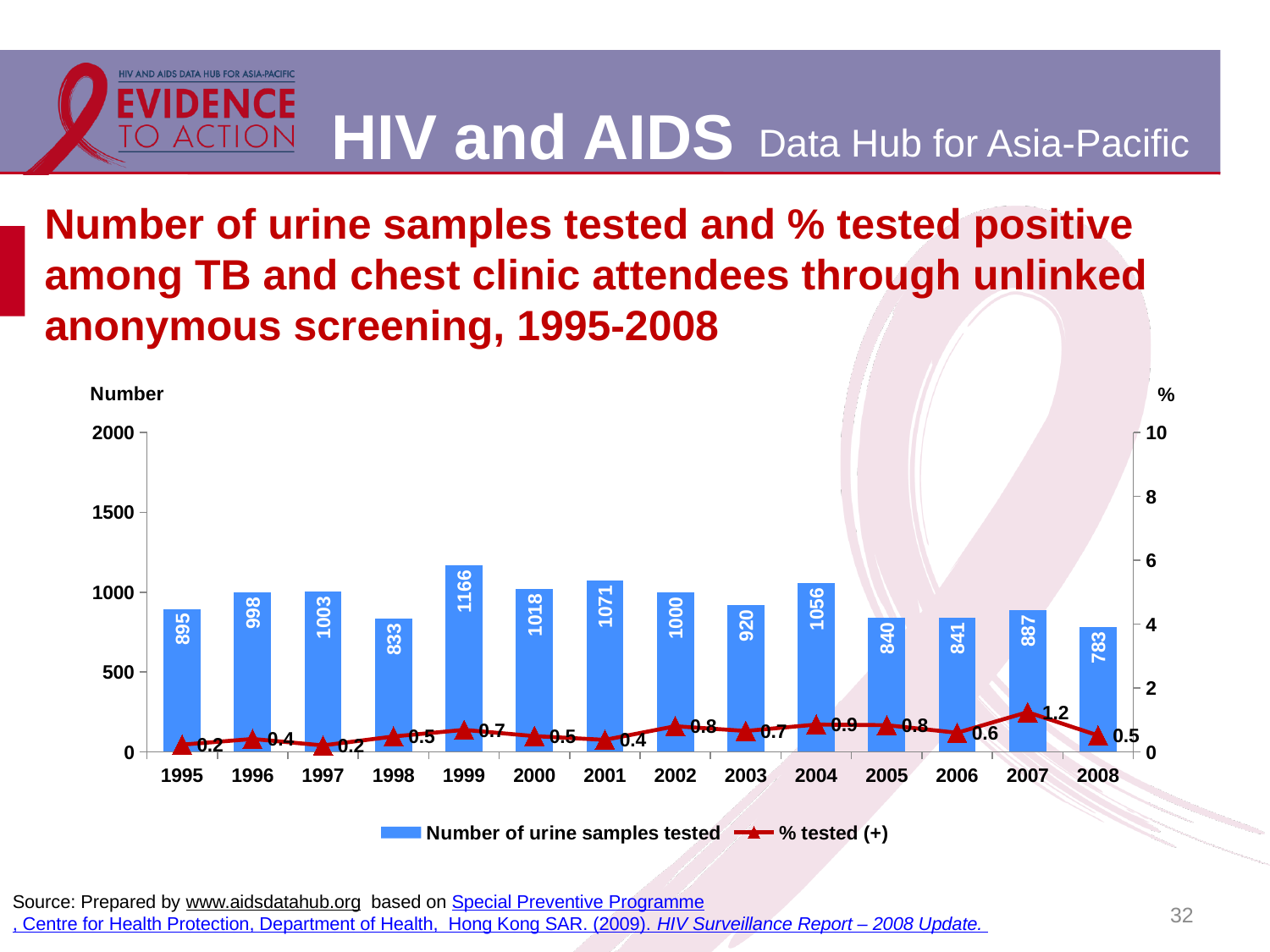
Which year had the highest number of urine samples tested? 1999 How many series does the chart legend list? 2 What colour are the bars showing the number of urine samples tested? Blue What was the % tested positive in 2007? 1.2 How many years are shown on the x axis of the chart? 14 Which year had more urine samples tested, 2001 or 2004? 2001 Which year had the lowest number of urine samples tested? 2008 What is the difference between the number of urine samples tested in 1999 and in 2008? 383 How many urine samples were tested in 2008? 783 Was the number of urine samples tested in 1998 greater or less than 1000? less How many urine samples were tested in 1999? 1166 Which year had the highest % tested positive? 2007